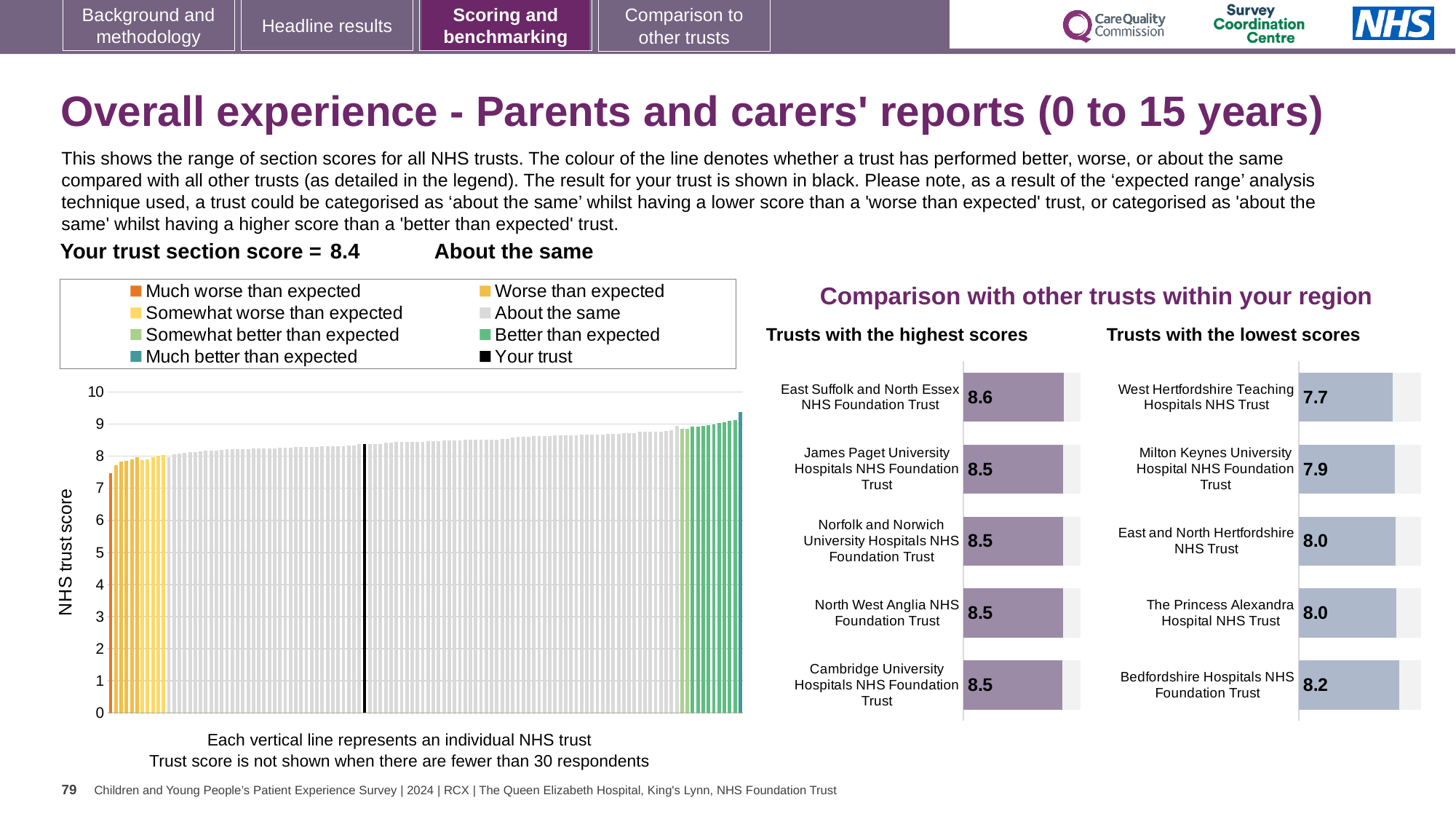
In the 'Trusts with the lowest scores' chart, what is the score for Bedfordshire Hospitals NHS Foundation Trust? 8.2 What kind of chart is the main chart on the left showing NHS trust scores? Bar chart How many trusts are shown in the 'Trusts with the highest scores' chart? 5 In the main NHS trust score chart, is the value for the black 'Your trust' bar greater or less than 8? greater In the 'Trusts with the highest scores' chart, which trust has the highest score? East Suffolk and North Essex NHS Foundation Trust How many entries does the legend of the main NHS trust score chart list? 8 In the 'Trusts with the lowest scores' chart, what is the difference between the scores of Bedfordshire Hospitals NHS Foundation Trust and West Hertfordshire Teaching Hospitals NHS Trust? 0.5 In the 'Trusts with the lowest scores' chart, what is the score for West Hertfordshire Teaching Hospitals NHS Trust? 7.7 In the 'Trusts with the highest scores' chart, what is the score for East Suffolk and North Essex NHS Foundation Trust? 8.6 In the main NHS trust score chart, do the bar values rise or fall from left to right along the x axis? Rise In the 'Trusts with the lowest scores' chart, which trust has the lowest score? West Hertfordshire Teaching Hospitals NHS Trust In the 'Trusts with the lowest scores' chart, which has the larger score: Milton Keynes University Hospital NHS Foundation Trust or Bedfordshire Hospitals NHS Foundation Trust? Bedfordshire Hospitals NHS Foundation Trust